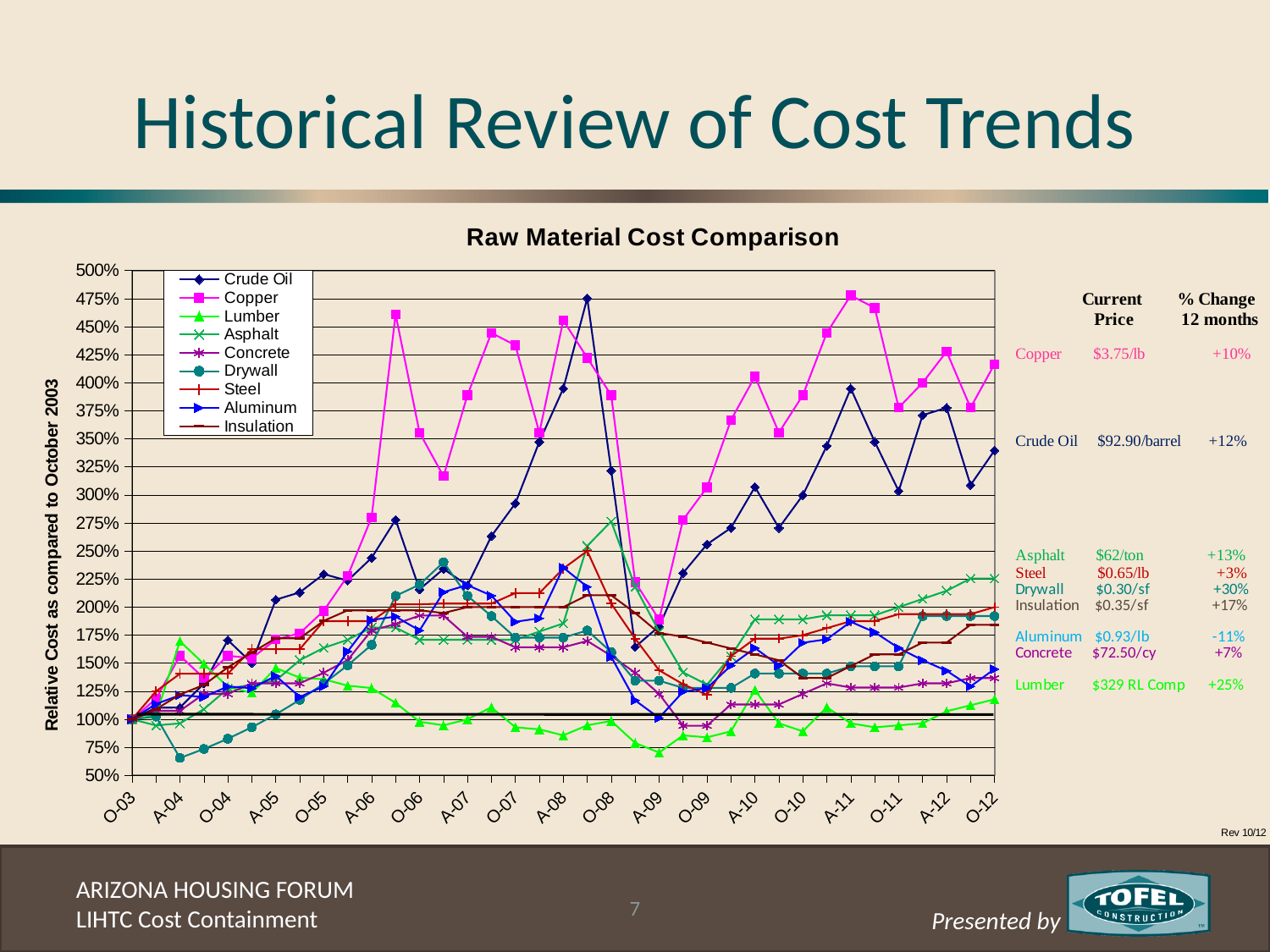
What is the title of the chart? Raw Material Cost Comparison Is the value for Drywall at A-04 greater or less than 100%? less What is the label of the vertical axis of the chart? Relative Cost as compared to October 2003 Which series has the highest value at O-12? Copper At O-06, which is higher, Copper or Crude Oil? Copper Is the value for Copper at O-06 greater or less than 400%? less How many series does the chart legend list? 9 Is the value for Crude Oil at O-08 greater or less than 450%? less Which series has the lowest value at O-12? Lumber What type of chart is shown on the slide? Line chart How many date labels are shown along the x axis of the chart? 19